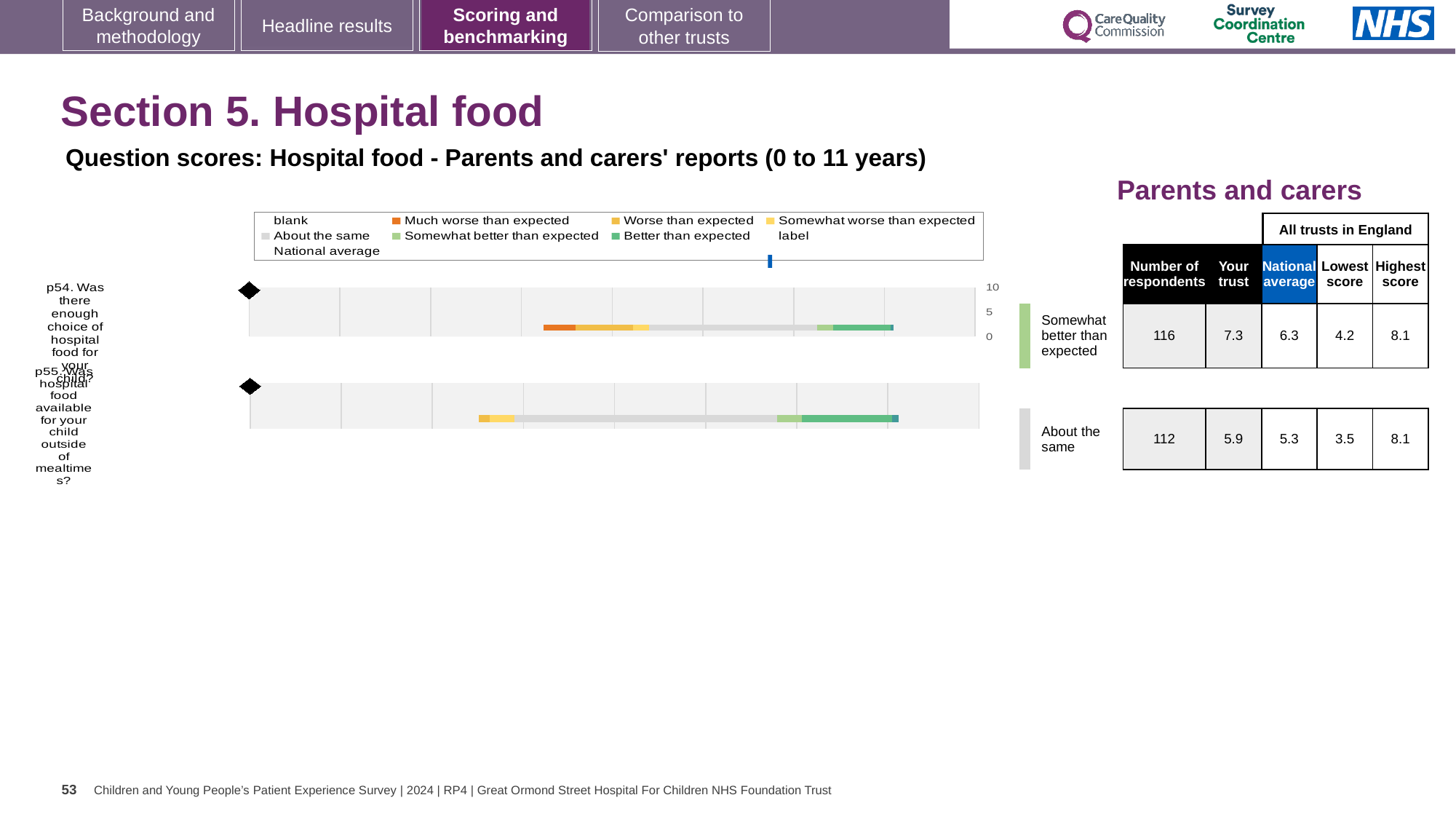
What is the lowest score among all trusts in England for p55? 3.5 What is the difference between the 'Your trust' score and the national average for p55? 0.6 How many questions (categories) are plotted in the hospital food chart? 2 Which benchmark category is p54 rated in? Somewhat better than expected What is the difference between the 'Your trust' score and the national average for p54? 1.0 What is the 'Your trust' score for p54 (enough choice of hospital food for your child)? 7.3 How many respondents answered p54? 116 What is the highest score among all trusts in England for p54? 8.1 What is the national average score for p55 (hospital food available outside of mealtimes)? 5.3 Which benchmark category is p55 rated in? About the same What kind of chart is used to show the question scores for p54 and p55? bar chart Which question has more respondents, p54 or p55? p54